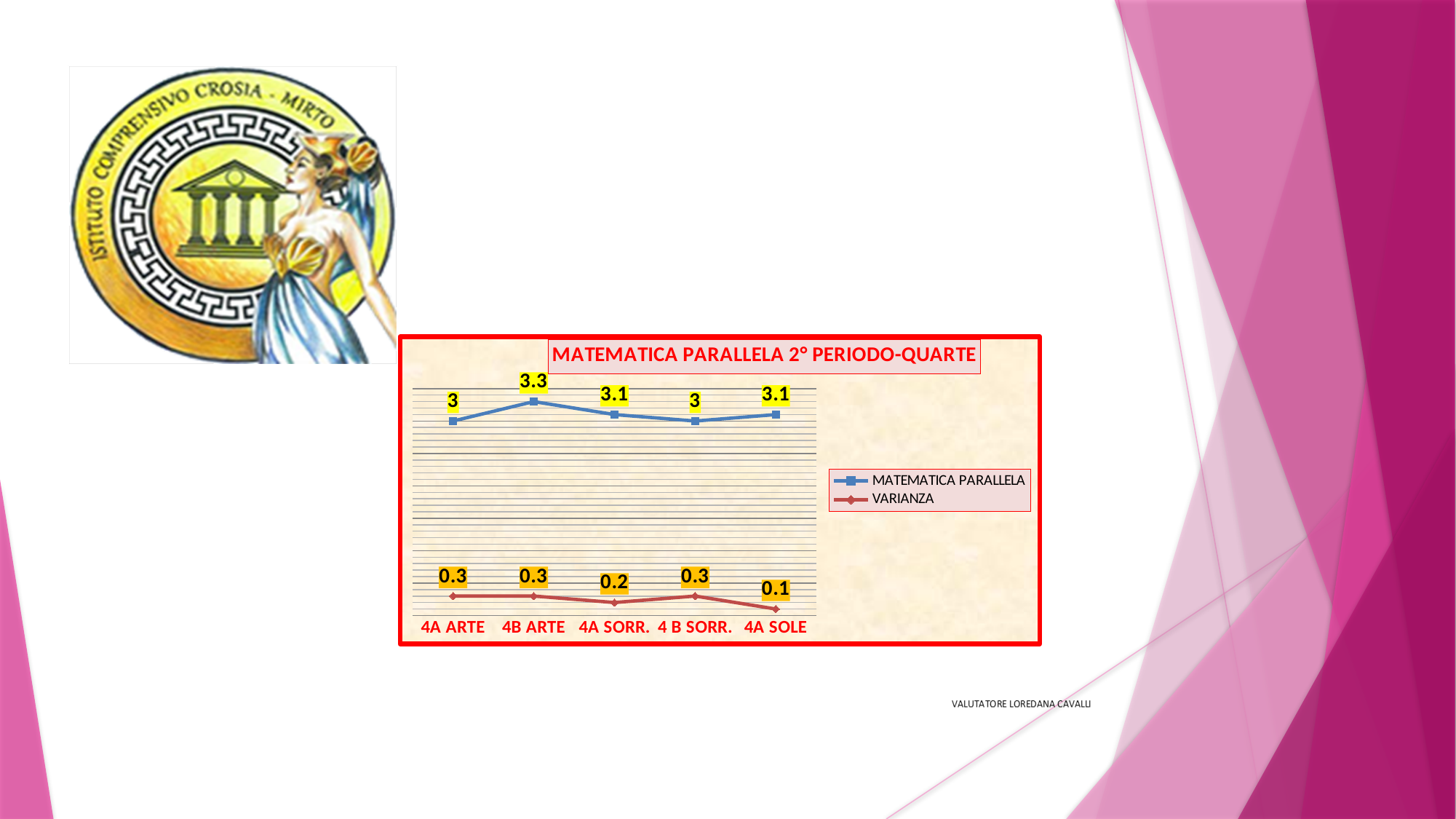
Which category has the lowest VARIANZA value? 4A SOLE What is the MATEMATICA PARALLELA value for 4A SORR.? 3.1 Which category has the highest MATEMATICA PARALLELA value? 4B ARTE What colour is the VARIANZA line? red What is the title of the chart? MATEMATICA PARALLELA 2° PERIODO-QUARTE How many categories are shown on the x axis? 5 What is the MATEMATICA PARALLELA value for 4B ARTE? 3.3 How many series does the legend list? 2 What kind of chart is shown? line chart What is the VARIANZA value for 4A SOLE? 0.1 What is the difference between the MATEMATICA PARALLELA values for 4B ARTE and 4 B SORR.? 0.3 Which is larger, the VARIANZA for 4A SORR. or for 4 B SORR.? 4 B SORR.